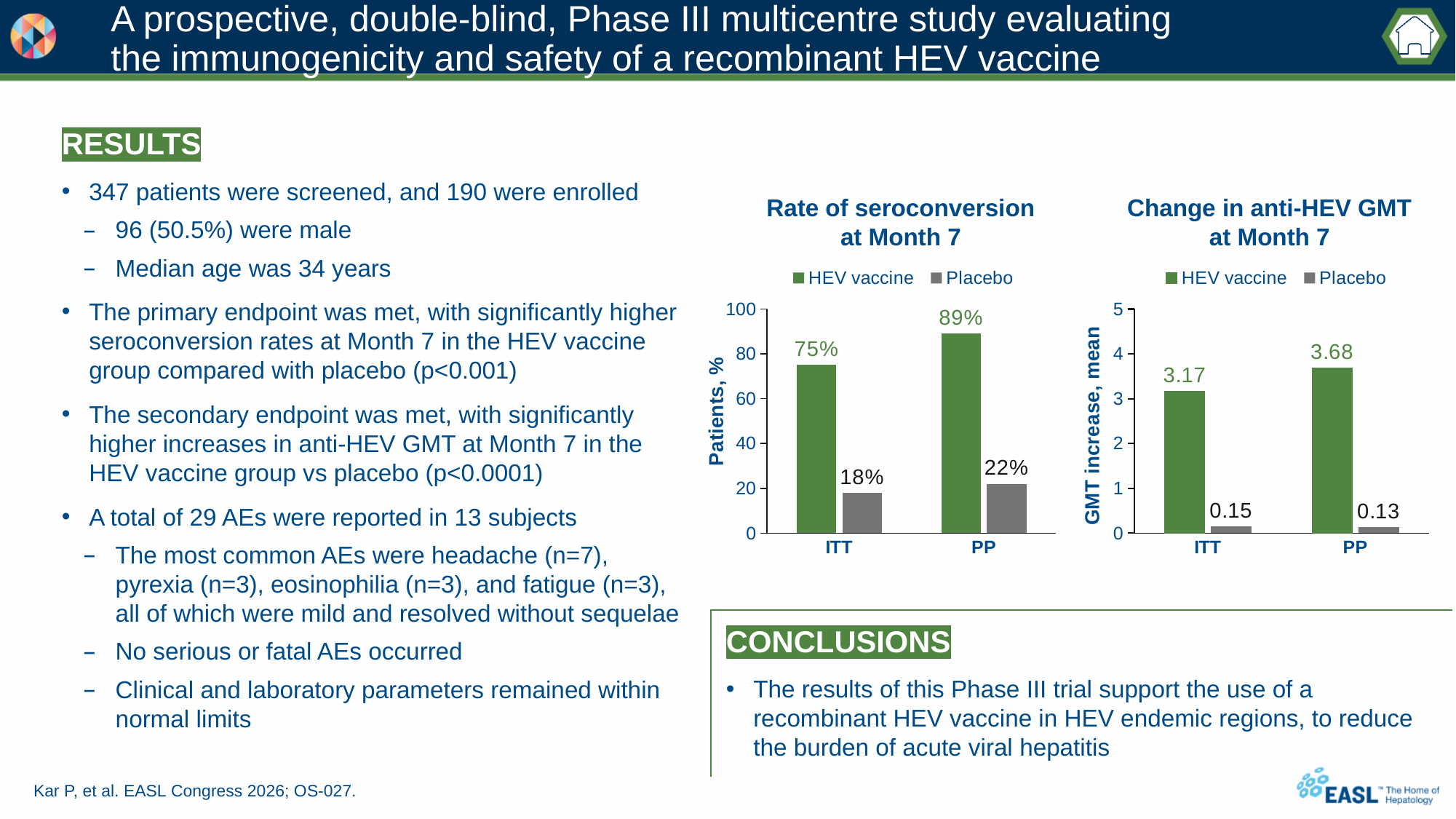
How many series does the legend of the 'Change in anti-HEV GMT at Month 7' chart list? 2 In the 'Rate of seroconversion at Month 7' chart, what is the value for HEV vaccine in the PP population? 89% In the 'Change in anti-HEV GMT at Month 7' chart, which bar is the lowest? Placebo, PP In the 'Rate of seroconversion at Month 7' chart, what is the value for Placebo in the ITT population? 18% In the 'Change in anti-HEV GMT at Month 7' chart, what is the value for Placebo in the PP population? 0.13 In the 'Rate of seroconversion at Month 7' chart, which bar is the highest? HEV vaccine, PP In the 'Rate of seroconversion at Month 7' chart, which is larger: Placebo in ITT or Placebo in PP? Placebo in PP In the 'Change in anti-HEV GMT at Month 7' chart, what is the difference between HEV vaccine in PP and HEV vaccine in ITT? 0.51 What is the y-axis label of the 'Change in anti-HEV GMT at Month 7' chart? GMT increase, mean What kind of chart is the 'Rate of seroconversion at Month 7' chart? Bar chart In the 'Rate of seroconversion at Month 7' chart, what is the difference between HEV vaccine and Placebo in the ITT population? 57% In the 'Change in anti-HEV GMT at Month 7' chart, what is the value for HEV vaccine in the ITT population? 3.17